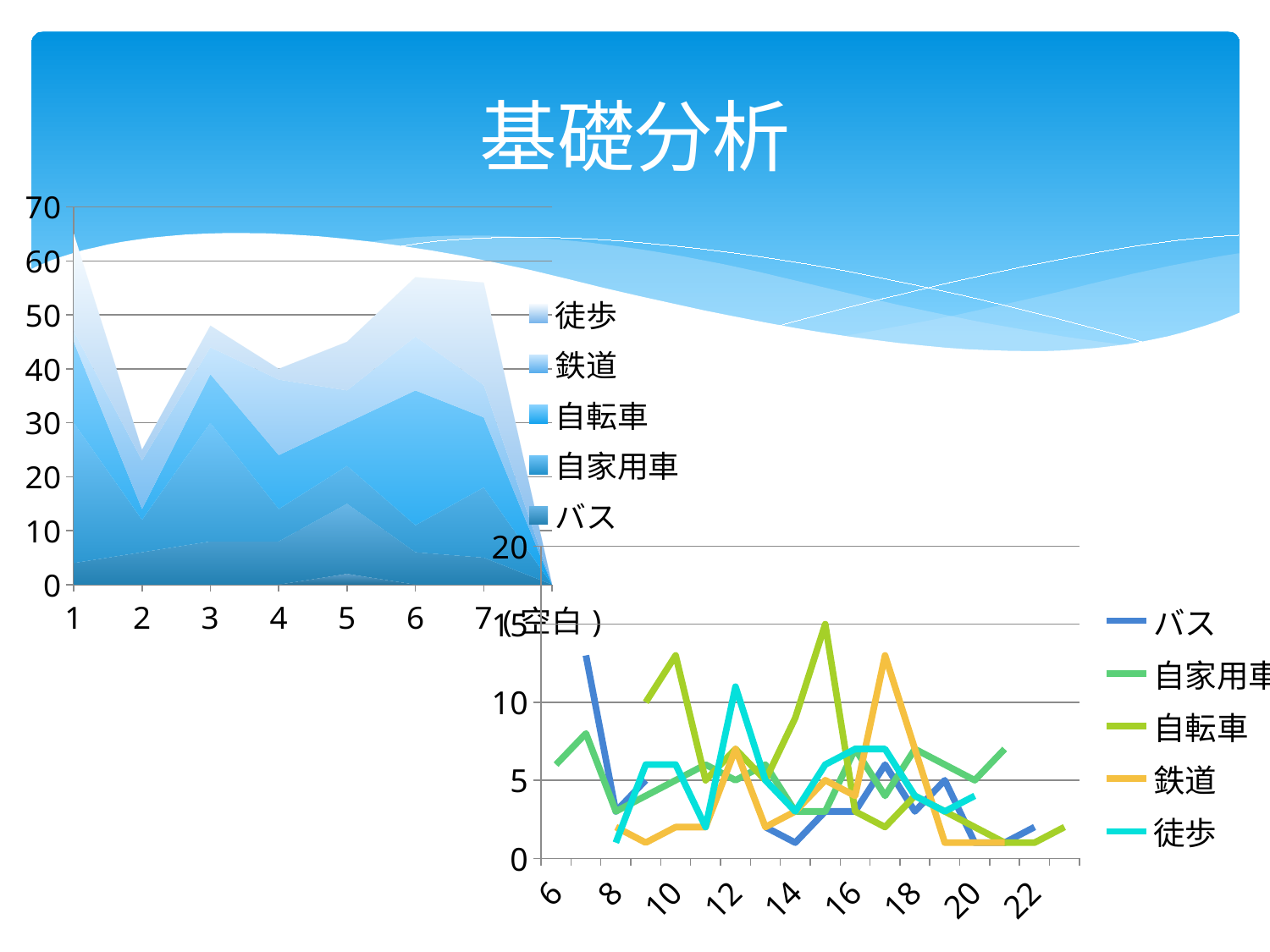
How many series does the legend of the left-hand area chart list? 5 In the left-hand area chart, does the total stacked value rise or fall from category 1 to category 2? fall In the left-hand area chart, is the total stacked value at category 7 greater or less than 50? greater What is the title of the slide? 基礎分析 In the left-hand area chart, is the total stacked value at category 2 greater or less than 30? less In the lower-right line chart, which series reaches the highest value? 自転車 What kind of chart is the chart on the lower right of the slide? line chart How many categories are shown on the x axis of the left-hand area chart? 8 How many series does the legend of the lower-right line chart list? 5 What kind of chart is the chart on the left side of the slide? stacked area chart In the lower-right line chart, is the value for 鉄道 at 17 greater or less than 10? greater In the lower-right line chart, does the バス line rise or fall from 7 to 8? fall